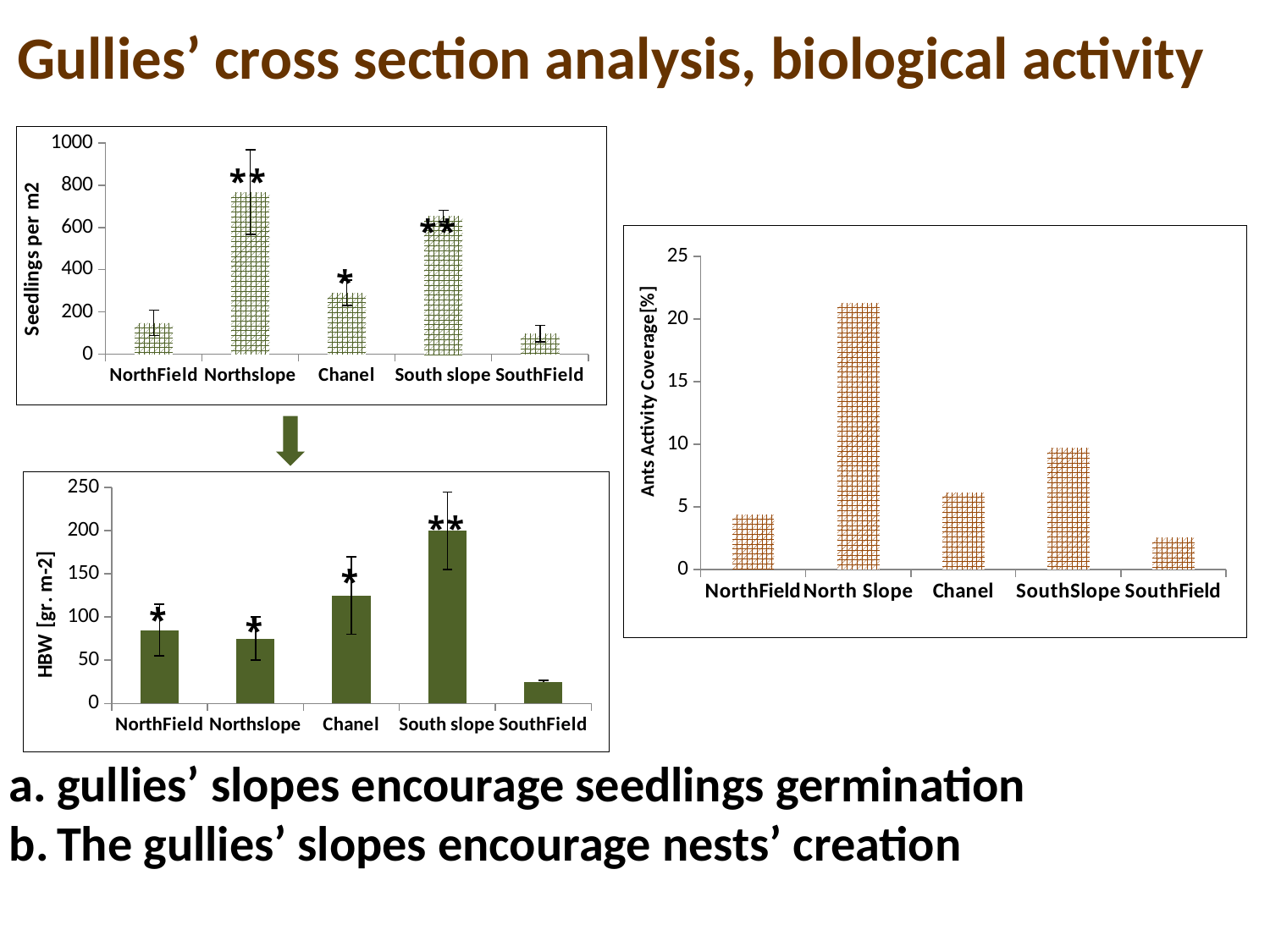
In the Ants Activity Coverage [%] chart (right), which category has the lowest value? SouthField In the HBW [gr. m-2] chart (bottom left), is the value for South slope greater or less than 150? greater In the Seedlings per m2 chart (top left), is the value for Northslope greater or less than 600? greater How many categories are shown in the Ants Activity Coverage [%] chart (right)? 5 In the HBW [gr. m-2] chart (bottom left), which category has the lowest value? SouthField In the HBW [gr. m-2] chart (bottom left), which category has the highest value? South slope In the Ants Activity Coverage [%] chart (right), is the value for North Slope greater or less than 20? greater In the Seedlings per m2 chart (top left), which category has the highest value? Northslope In the Seedlings per m2 chart (top left), which is larger, South slope or Chanel? South slope In the Ants Activity Coverage [%] chart (right), which category has the highest value? North Slope